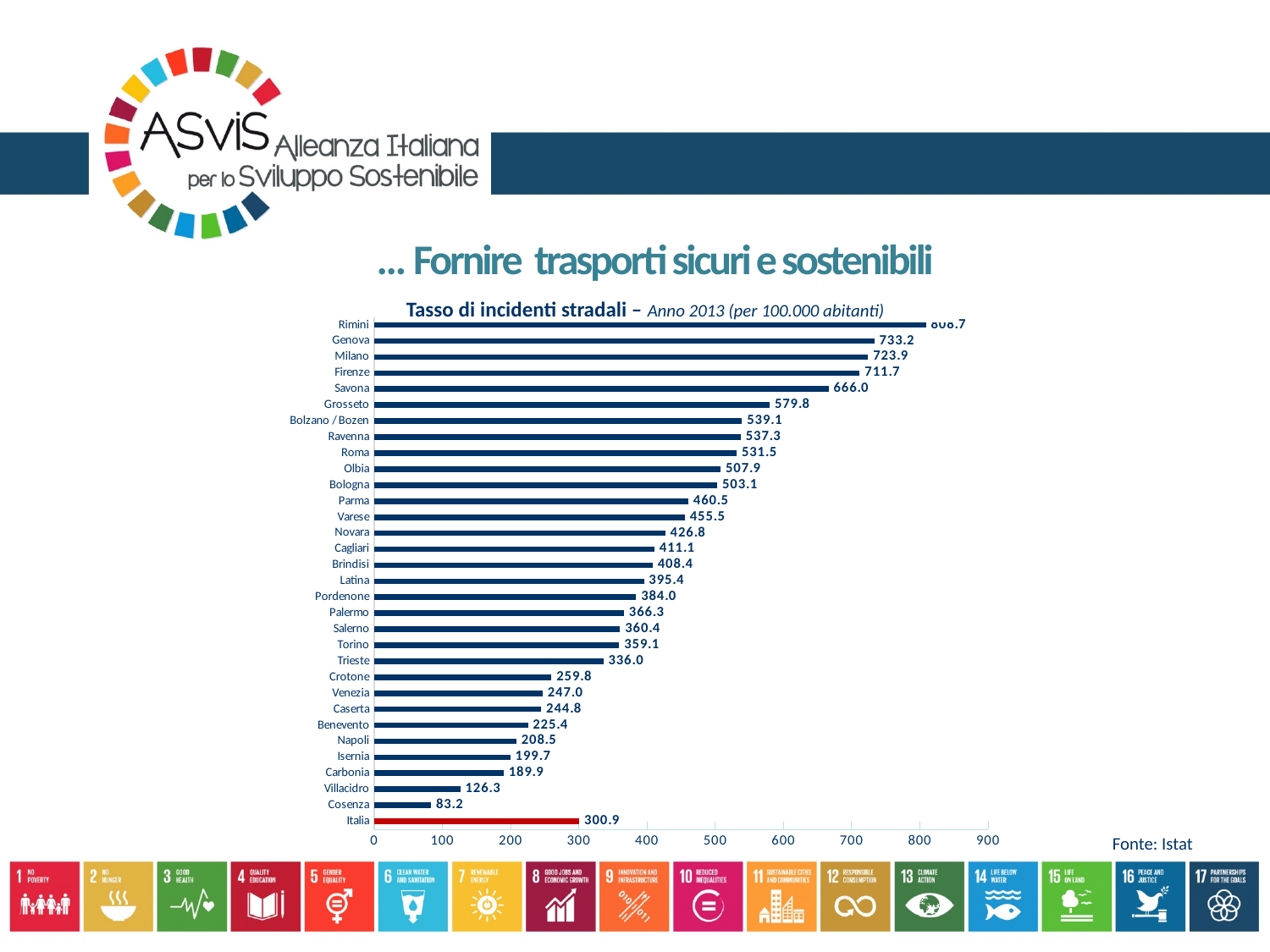
Which category has the highest value? Rimini How many categories are shown in the chart? 32 Which bar is shown in red rather than blue? Italia What is the value for Napoli? 208.5 What is the value for Italia? 300.9 What is the difference between the values for Genova and Milano? 9.3 What kind of chart is this? Bar chart Is the value for Rimini greater or less than 800? greater Which is larger, the value for Palermo or the value for Napoli? Palermo Which category has the lowest value? Cosenza What is the value for Genova? 733.2 What is the difference between the values for Roma and Italia? 230.6